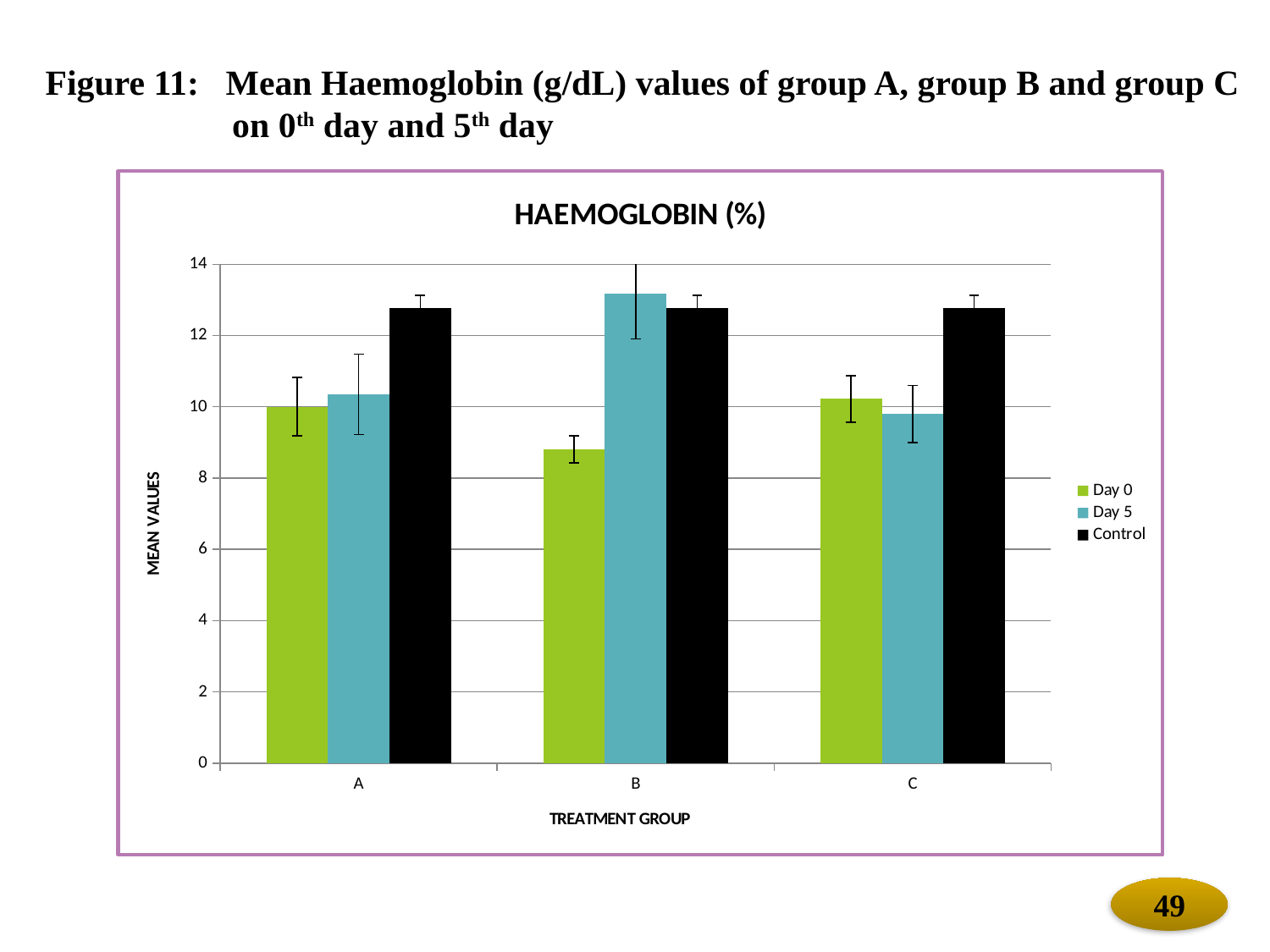
Which treatment group has the highest Day 5 value? B What is the title of the chart? HAEMOGLOBIN (%) For treatment group B, which is larger: the Day 0 value or the Day 5 value? Day 5 For treatment group A, which is larger: the Day 0 value or the Control value? Control How many series does the legend list? 3 Is the Day 0 value for treatment group C greater or less than 8? greater How many treatment groups are shown on the x axis? 3 Is the Day 5 value for treatment group B greater or less than 12? greater Is the Control value for treatment group A greater or less than 12? greater Which treatment group has the lowest Day 0 value? B What kind of chart is shown on the slide? bar chart